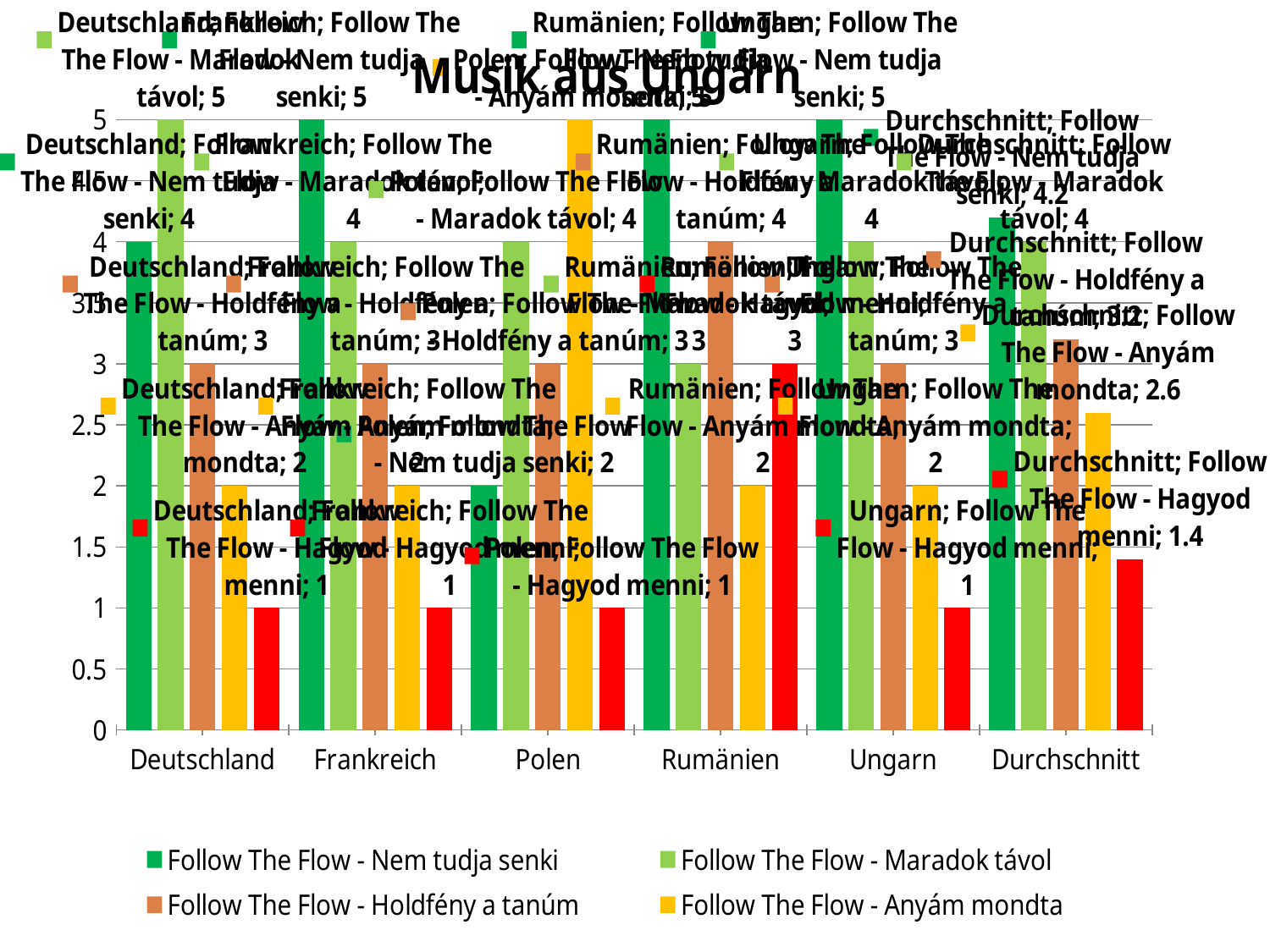
Is the value for Durchschnitt in the series Follow The Flow - Holdfény a tanúm greater or less than 3? greater How many categories are shown on the x axis of the chart? 6 For Polen, which is larger: the value for Follow The Flow - Nem tudja senki or the value for Follow The Flow - Anyám mondta? Follow The Flow - Anyám mondta What is the value for Polen in the series Follow The Flow - Anyám mondta? 5 How many series does the chart's legend list? 4 Which category has the highest value in the series Follow The Flow - Anyám mondta? Polen What kind of chart is shown on the slide? bar chart What is the value for Durchschnitt in the series Follow The Flow - Holdfény a tanúm? 3.2 What is the value for Durchschnitt in the series Follow The Flow - Nem tudja senki? 4.2 What is the difference between the Durchschnitt values for Follow The Flow - Nem tudja senki and Follow The Flow - Anyám mondta? 1.6 What is the value for Durchschnitt in the series Follow The Flow - Anyám mondta? 2.6 What is the title of the chart? Musik aus Ungarn